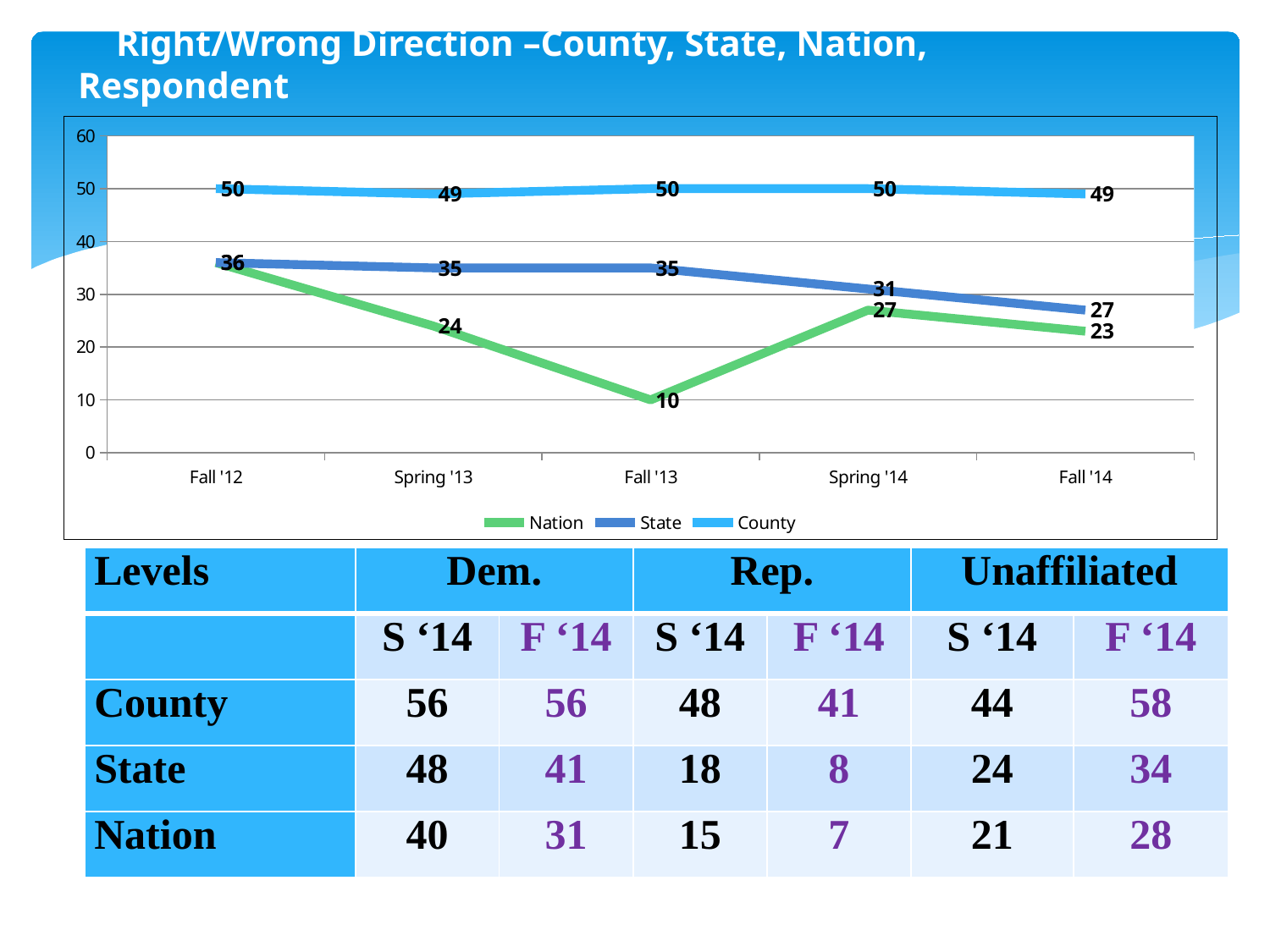
Which colour represents the Nation series in the legend? Green What is the difference between the County and Nation values at Fall '13? 40 Which is larger at Spring '14, the State value or the Nation value? State What kind of chart is shown on the slide? Line chart What is the value for County at Spring '13? 49 How many series does the legend list? 3 What is the value for State at Fall '14? 27 What is the value for Nation at Fall '13? 10 How many time points are plotted on the x axis? 5 At which time point is the Nation series lowest? Fall '13 Does the State series rise or fall from Fall '13 to Fall '14? Fall Which series has the highest value at Fall '14? County